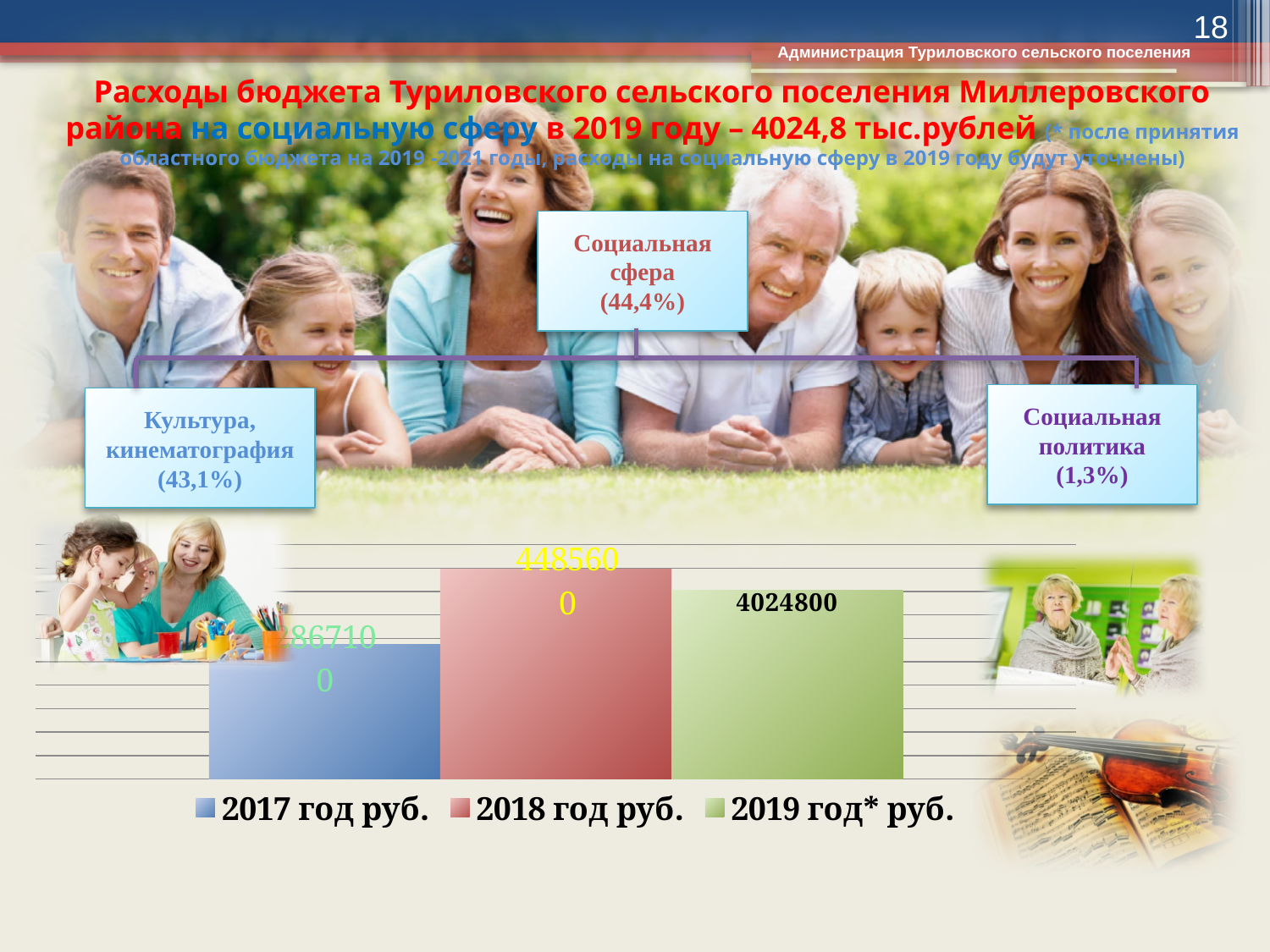
What colour is the bar for 2017 год руб. in the chart? blue Do the values in the chart rise or fall from 2018 год руб. to 2019 год* руб.? fall Which is larger in the bar chart: the value for 2018 год руб. or the value for 2019 год* руб.? 2018 год руб. What is the difference between the values for 2018 год руб. and 2019 год* руб. in the bar chart? 460800 How many bars are plotted in the chart? 3 Which series has the highest value in the bar chart? 2018 год руб. What kind of chart is shown on the slide? bar chart How many series does the chart legend list? 3 What is the value for 2018 год руб. in the bar chart? 4485600 What is the value for 2019 год* руб. in the bar chart? 4024800 What colour is the bar for 2019 год* руб. in the chart? green Which series has the lowest value in the bar chart? 2017 год руб.